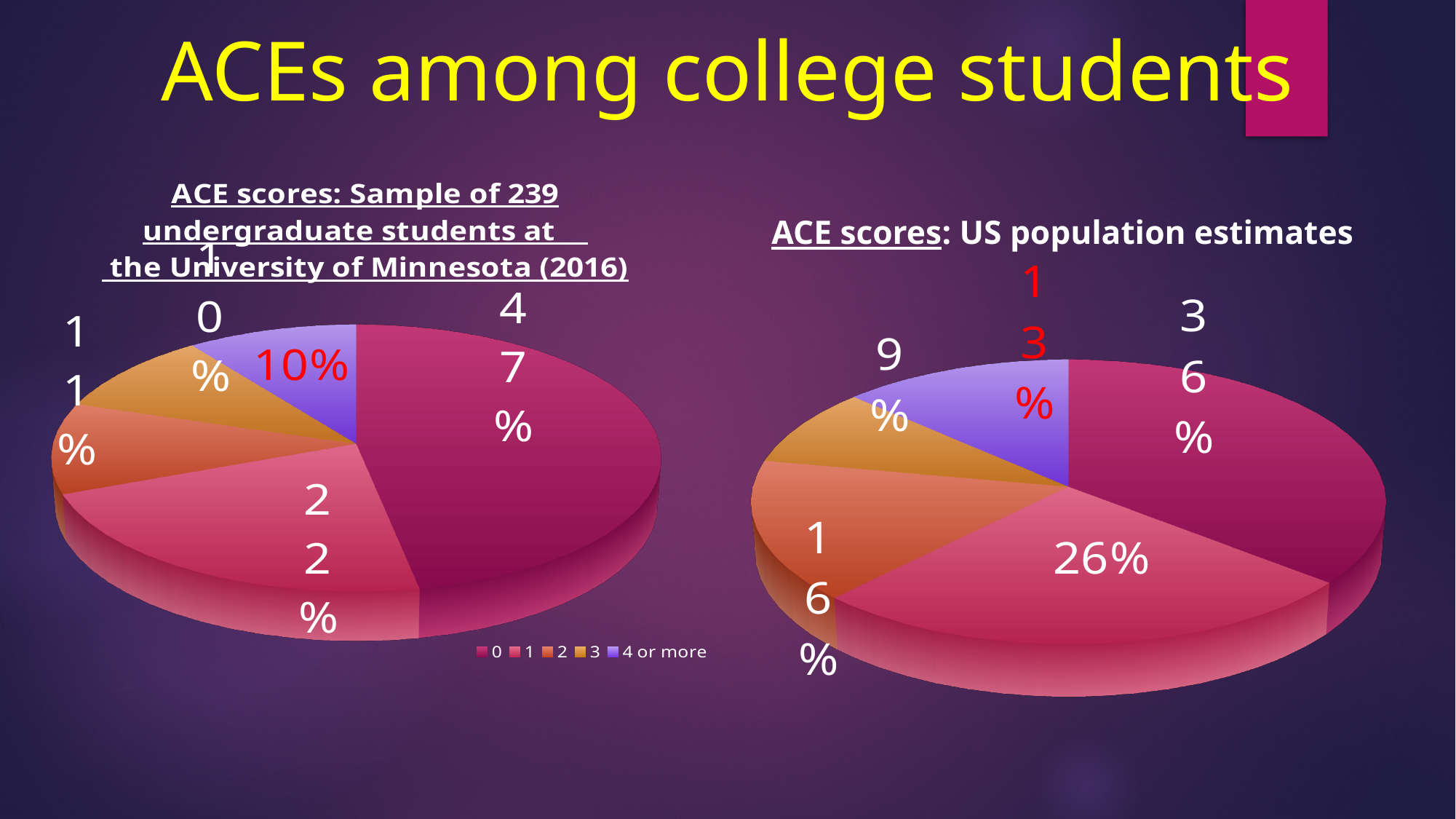
In the 'ACE scores: US population estimates' chart, what percentage is shown for an ACE score of 1? 26% In the 'ACE scores: US population estimates' chart, what percentage is shown for an ACE score of 0? 36% In the 'ACE scores: US population estimates' chart, what percentage is shown for '4 or more' ACEs? 13% What is the difference between the share for an ACE score of 0 in the University of Minnesota sample chart and in the US population estimates chart? 11 percentage points What kind of chart is the 'ACE scores: US population estimates' chart? pie chart In the 'ACE scores: US population estimates' chart, which ACE score category has the largest share? 0 In the 'ACE scores: US population estimates' chart, which ACE score category has the smallest share? 3 How many ACE score categories does the legend of the University of Minnesota sample chart list? 5 In the University of Minnesota sample chart, what percentage of students had an ACE score of 0? 47% Which is larger: the share for '4 or more' ACEs in the University of Minnesota sample chart or in the US population estimates chart? US population estimates In the University of Minnesota sample chart, what percentage of students had 4 or more ACEs? 10% In the University of Minnesota sample chart, what percentage of students had an ACE score of 1? 22%